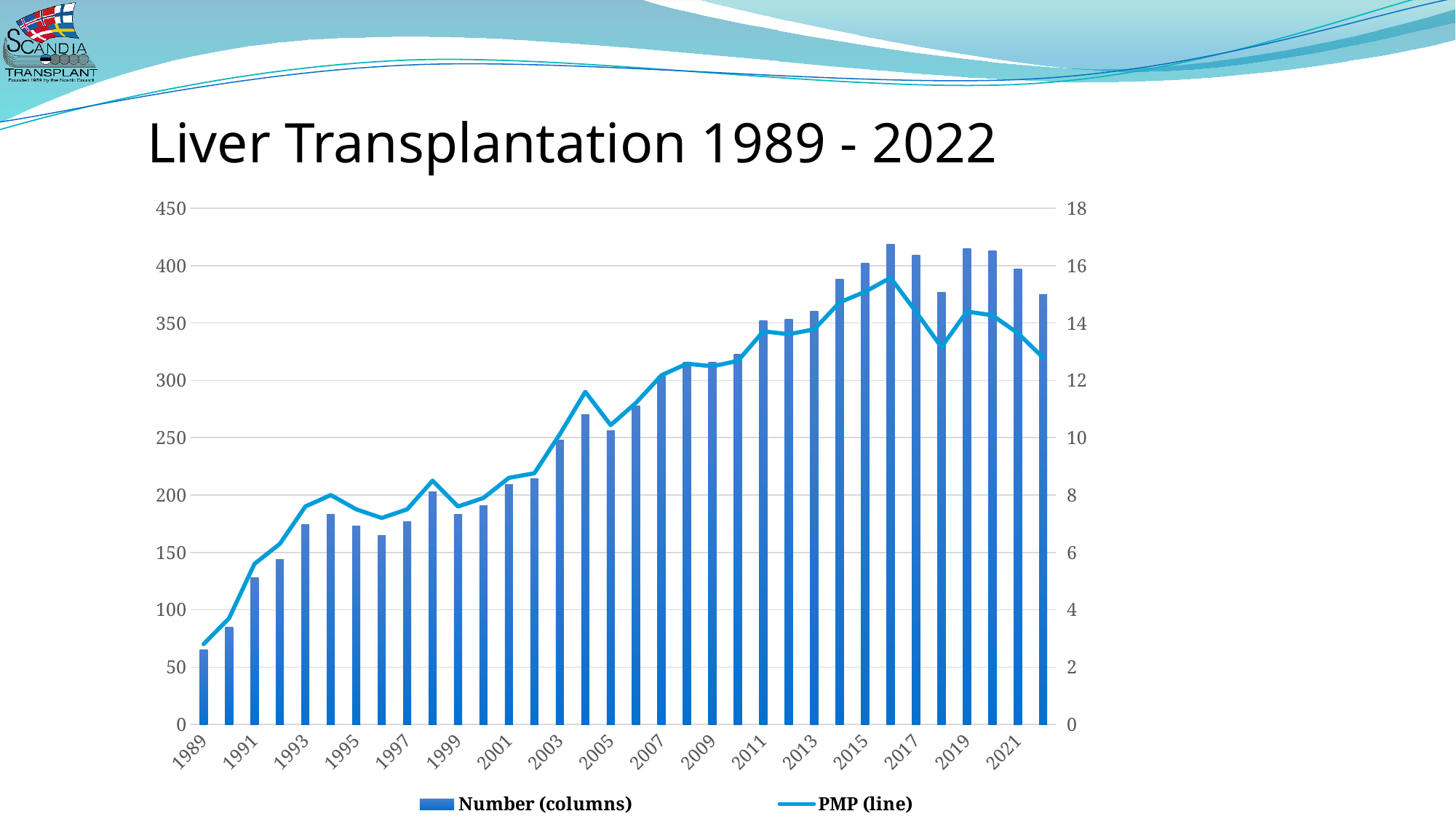
Is the number of liver transplantations in 1989 greater or less than 100? less Is the PMP value for 1989 greater or less than 4? less What kind of chart is shown on the slide? A combined bar and line chart How many years (bars) are plotted on the chart? 34 What are the two series named in the legend? Number (columns) and PMP (line) Is the number of liver transplantations in 2016 greater or less than 400? greater How many series does the legend list? 2 Overall, does the number of liver transplantations rise or fall from 1989 to 2022? rise Which year has the lowest number of liver transplantations (shortest bar)? 1989 Which year has the larger number of liver transplantations, 2018 or 2019? 2019